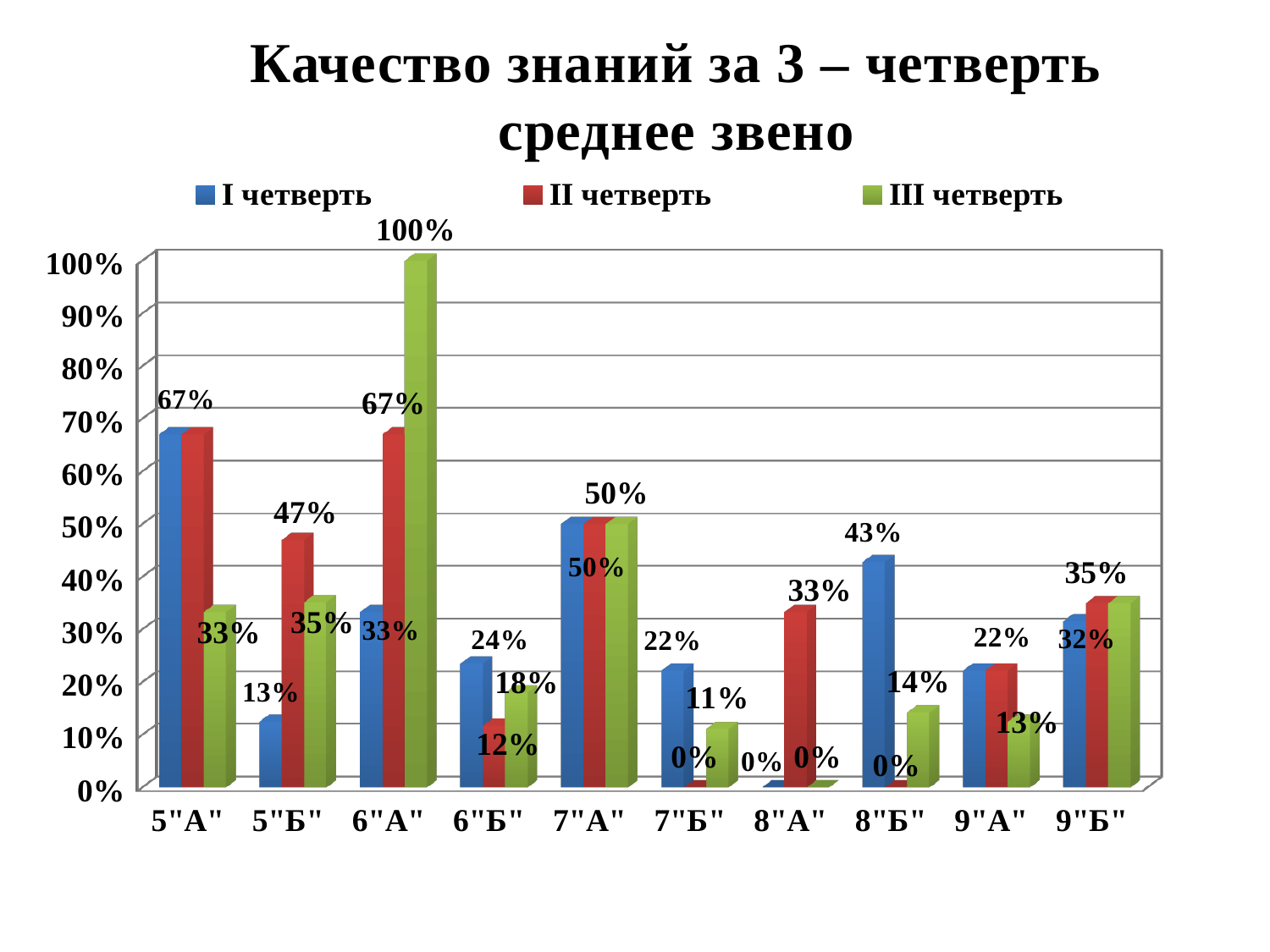
Which category has the highest value in the III четверть series? 6"А" What is the value for 9"А" in the III четверть series? 13% What is the value for 5"Б" in the II четверть series? 47% What is the difference between the III четверть values for 6"А" and 5"Б"? 65% What is the difference between the II четверть values for 5"Б" and 6"Б"? 35% How many categories (classes) are shown on the x axis? 10 What is the value for 6"А" in the III четверть series? 100% What is the value for 8"Б" in the I четверть series? 43% What is the value for 6"Б" in the I четверть series? 24% What kind of chart is shown on the slide? Bar chart How many series does the legend list? 3 Which has the larger I четверть value, 8"Б" or 5"Б"? 8"Б"